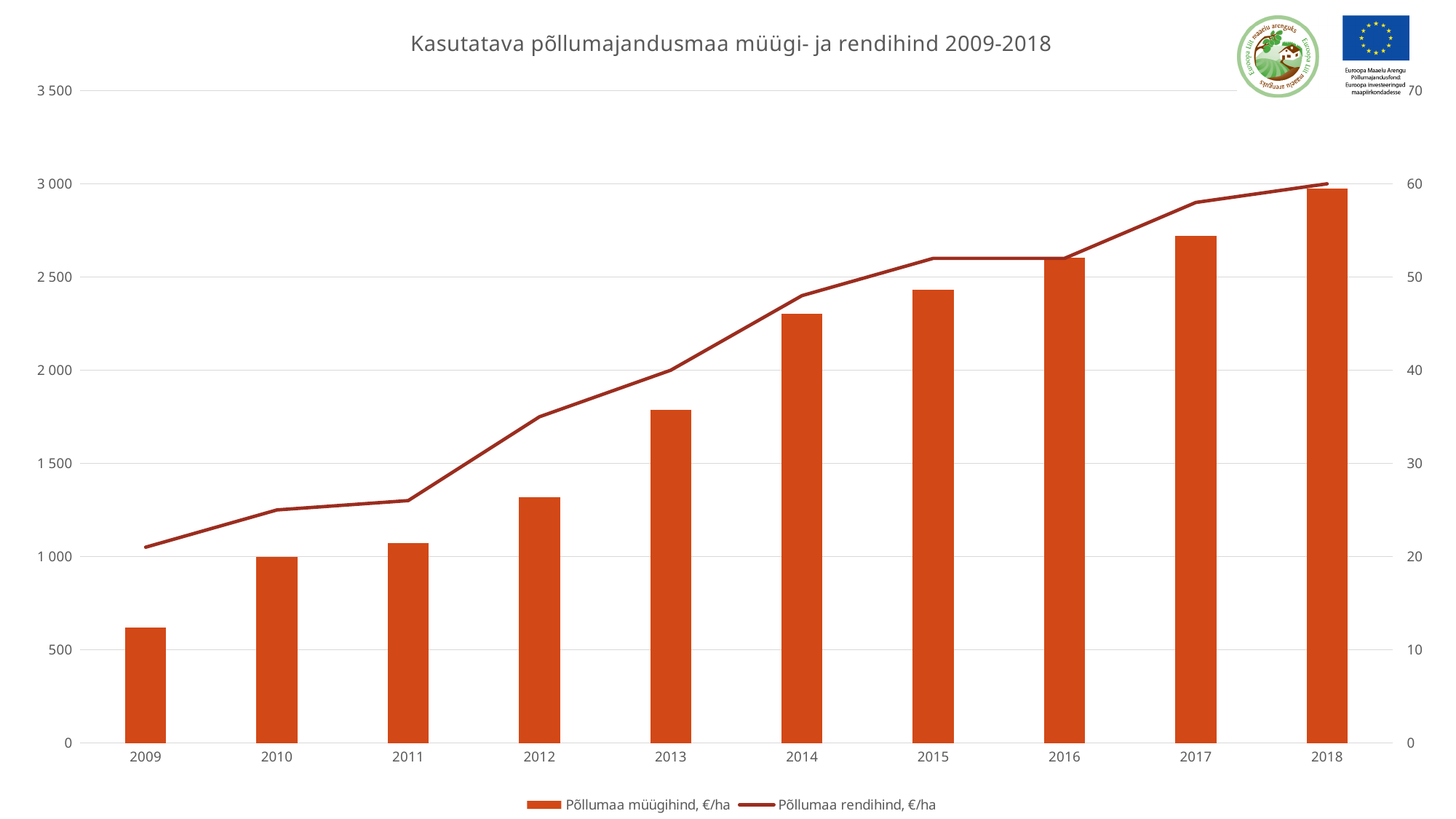
Do the values for Põllumaa rendihind, €/ha generally rise or fall from 2009 to 2018? rise How many years are shown on the x axis of the chart? 10 Which year has the highest value for Põllumaa müügihind, €/ha? 2018 What kind of chart is shown on the slide? bar and line chart What is the title of the chart? Kasutatava põllumajandusmaa müügi- ja rendihind 2009-2018 Is the value for Põllumaa müügihind, €/ha in 2014 greater or less than 2 000? greater Is the value for Põllumaa müügihind, €/ha in 2009 greater or less than 1 000? less Which is larger, the Põllumaa müügihind, €/ha value for 2013 or for 2012? 2013 How many series does the legend list? 2 Which year has the lowest value for Põllumaa müügihind, €/ha? 2009 Is the value for Põllumaa rendihind, €/ha in 2012 greater or less than 30 on the right axis? greater